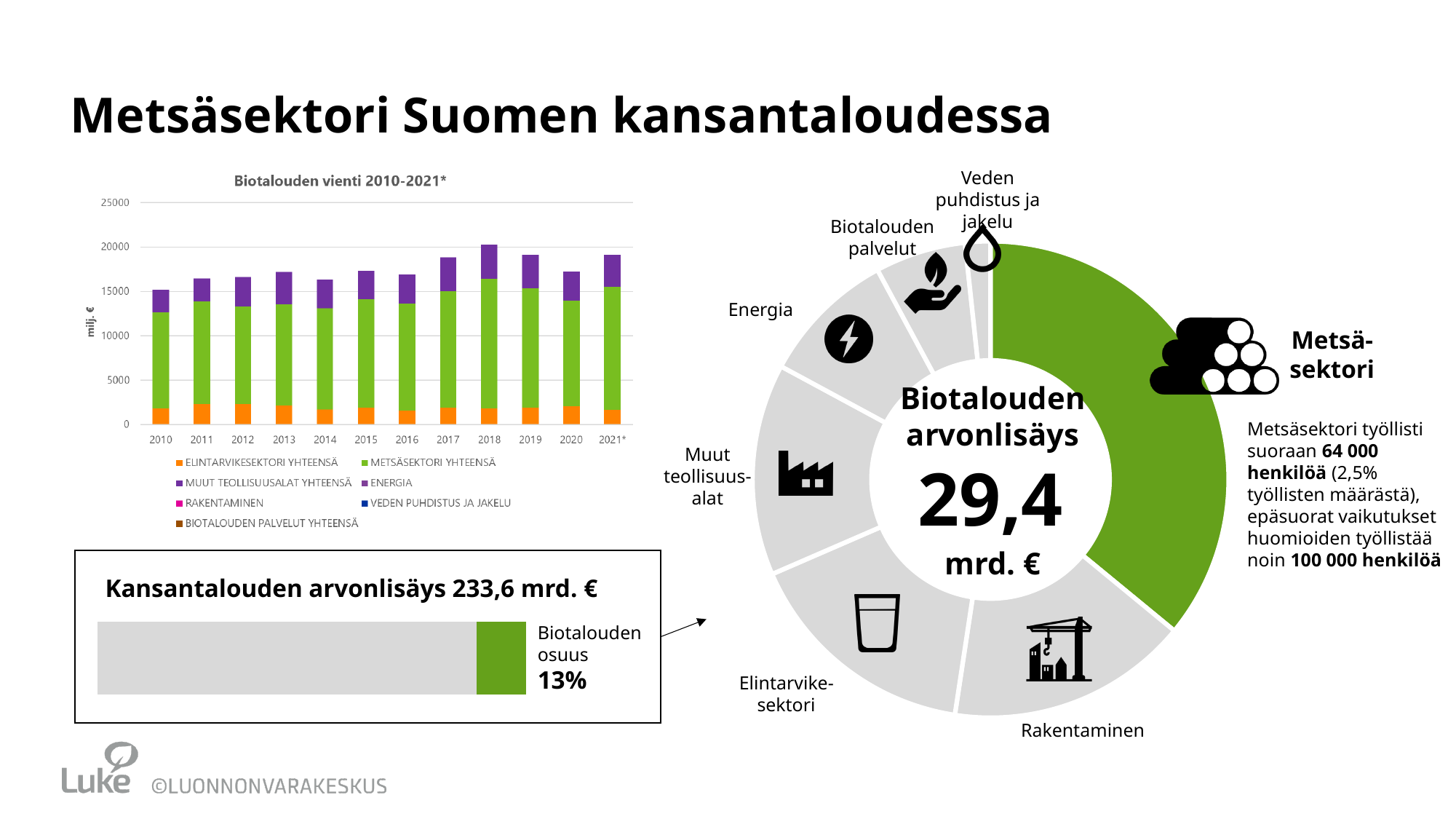
In the chart 'Biotalouden vienti 2010-2021*', is the total bar for 2010 greater or less than 20000? less In the chart 'Biotalouden vienti 2010-2021*', how many years are shown on the x axis? 12 In the chart 'Biotalouden vienti 2010-2021*', which series forms the largest part of each bar? METSÄSEKTORI YHTEENSÄ In the chart 'Biotalouden vienti 2010-2021*', which year has the larger total bar, 2018 or 2020? 2018 In the chart 'Biotalouden vienti 2010-2021*', is the total bar for 2017 greater or less than 15000? greater In the chart 'Biotalouden vienti 2010-2021*', which year has the lowest total bar? 2010 What kind of chart is 'Biotalouden vienti 2010-2021*'? stacked bar chart How many series does the legend of 'Biotalouden vienti 2010-2021*' list? 7 In the chart 'Biotalouden vienti 2010-2021*', which year has the highest total bar? 2018 What is the unit shown on the y axis of 'Biotalouden vienti 2010-2021*'? milj. € In the donut chart 'Biotalouden arvonlisäys', what total value is shown in the centre? 29,4 mrd. € In the donut chart 'Biotalouden arvonlisäys', which sector has the largest segment? Metsäsektori